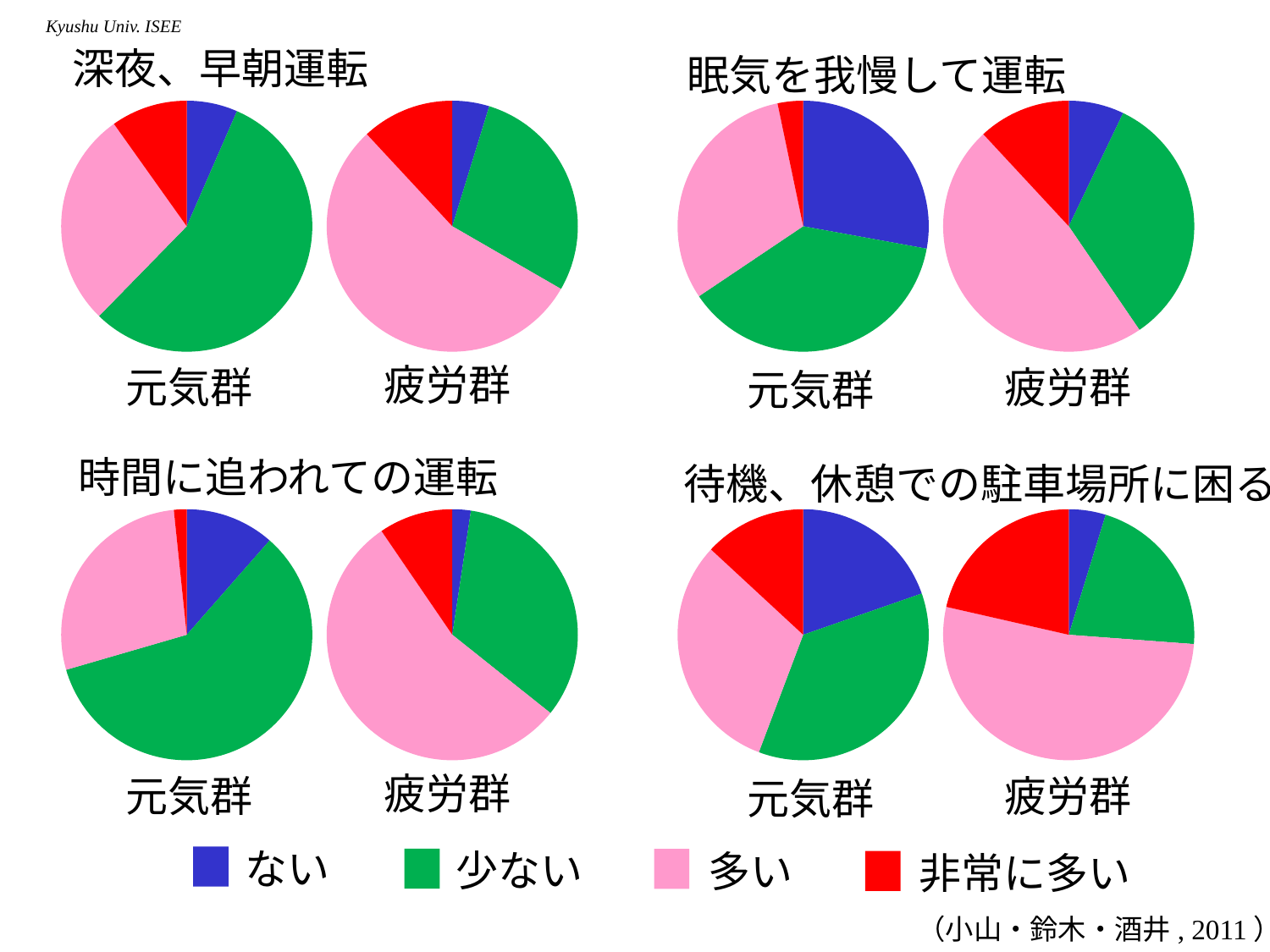
In the 時間に追われての運転 疲労群 pie, which is larger, the 多い slice or the 少ない slice? 多い In the 待機、休憩での駐車場所に困る 疲労群 pie, which category has the largest slice? 多い In the 時間に追われての運転 元気群 pie, which category has the smallest slice? 非常に多い How many categories does the legend list? 4 In the 深夜、早朝運転 疲労群 pie, which category has the largest slice? 多い In the 深夜、早朝運転 元気群 pie, which category has the largest slice? 少ない Which colour represents 非常に多い in the legend? Red How many pie charts are on the slide? 8 What kind of charts are shown on the slide? Pie charts In the 深夜、早朝運転 疲労群 pie, which category has the smallest slice? ない In the 眠気を我慢して運転 元気群 pie, which category has the smallest slice? 非常に多い